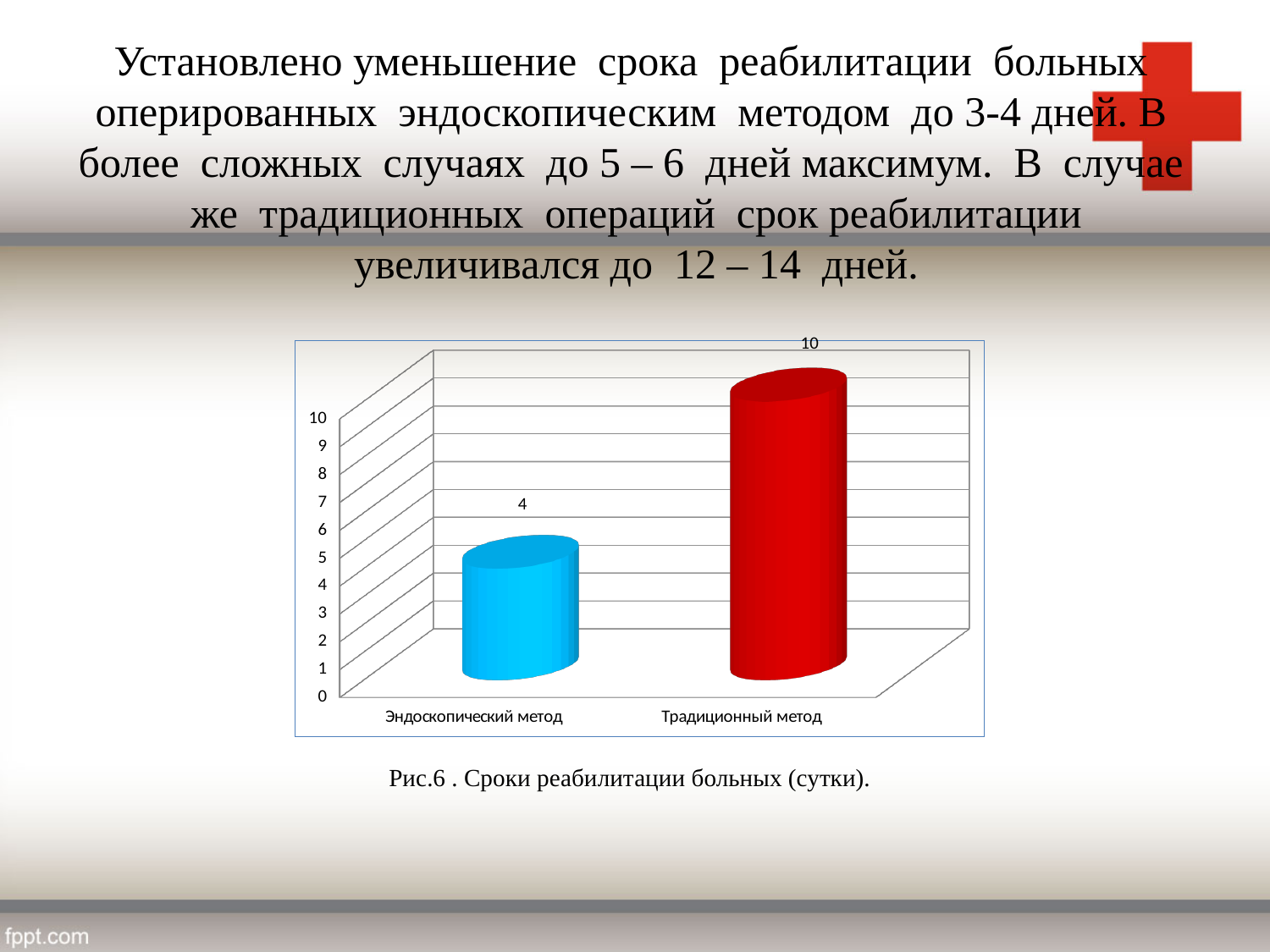
What colour is the bar for Традиционный метод? red Which category has the lowest value? Эндоскопический метод What is the value for Традиционный метод? 10 How many categories are shown on the x axis? 2 Which is larger: the value for Эндоскопический метод or the value for Традиционный метод? Традиционный метод What kind of chart is shown on the slide? bar chart What is the difference between the values for Традиционный метод and Эндоскопический метод? 6 Is the value for Традиционный метод greater or less than 8? greater What is the caption of the figure below the chart? Рис.6 . Сроки реабилитации больных (сутки). Which category has the highest value? Традиционный метод What is the value for Эндоскопический метод? 4 Is the value for Эндоскопический метод greater or less than 5? less